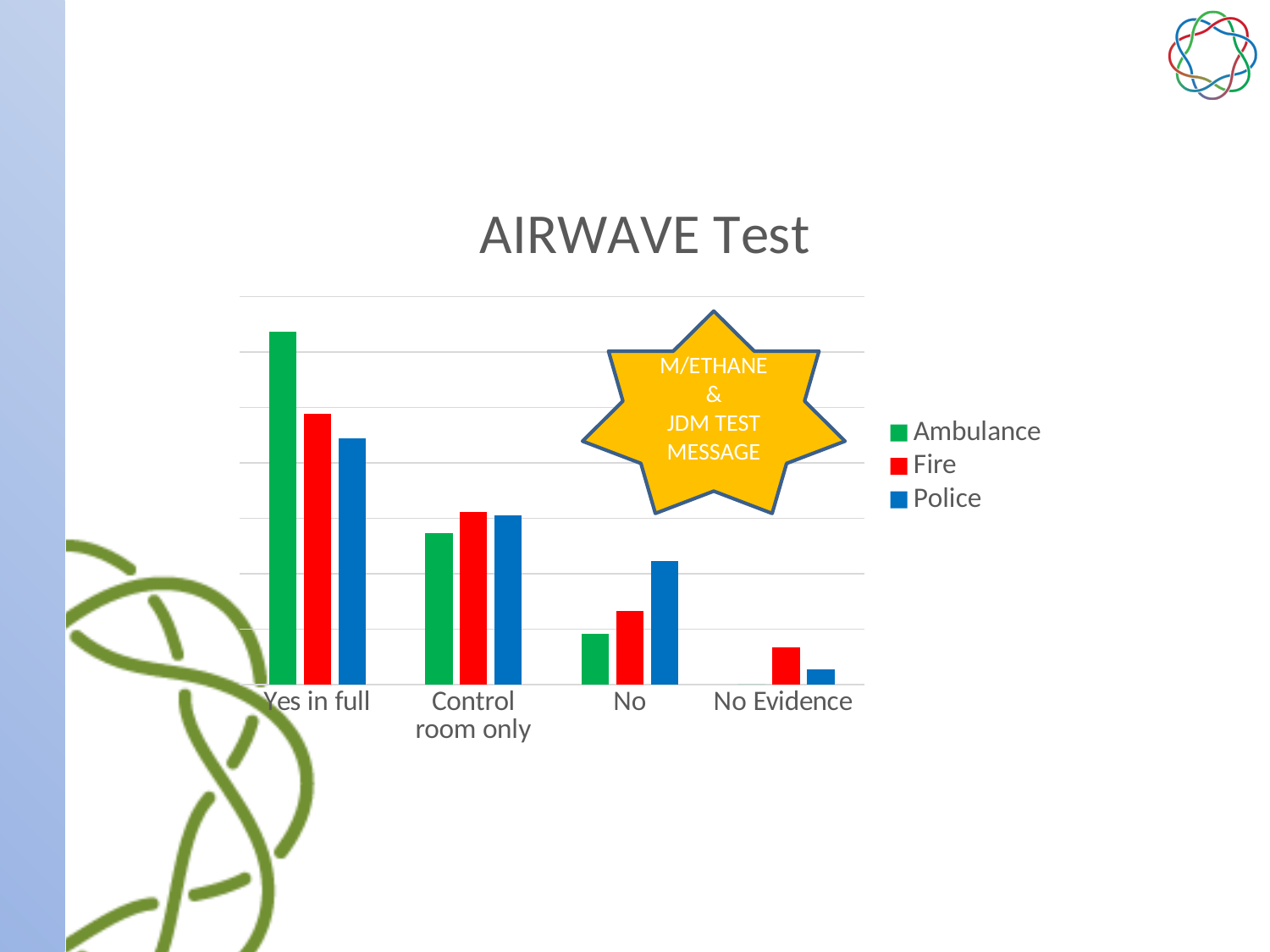
How many series does the legend list? 3 Which series has the highest value in the 'Yes in full' category? Ambulance Which colour represents Fire in the legend? Red What type of chart is shown on the slide? Bar chart Do the Ambulance values rise or fall from 'Yes in full' to 'No Evidence'? Fall What is the title of the chart? AIRWAVE Test How many categories are shown on the x axis? 4 Which series has the highest value in the 'No' category? Police In the 'No Evidence' category, which is larger, Fire or Police? Fire In the 'Control room only' category, which is larger, Ambulance or Fire? Fire For which category is the Police value lowest? No Evidence For which category is the Ambulance value highest? Yes in full